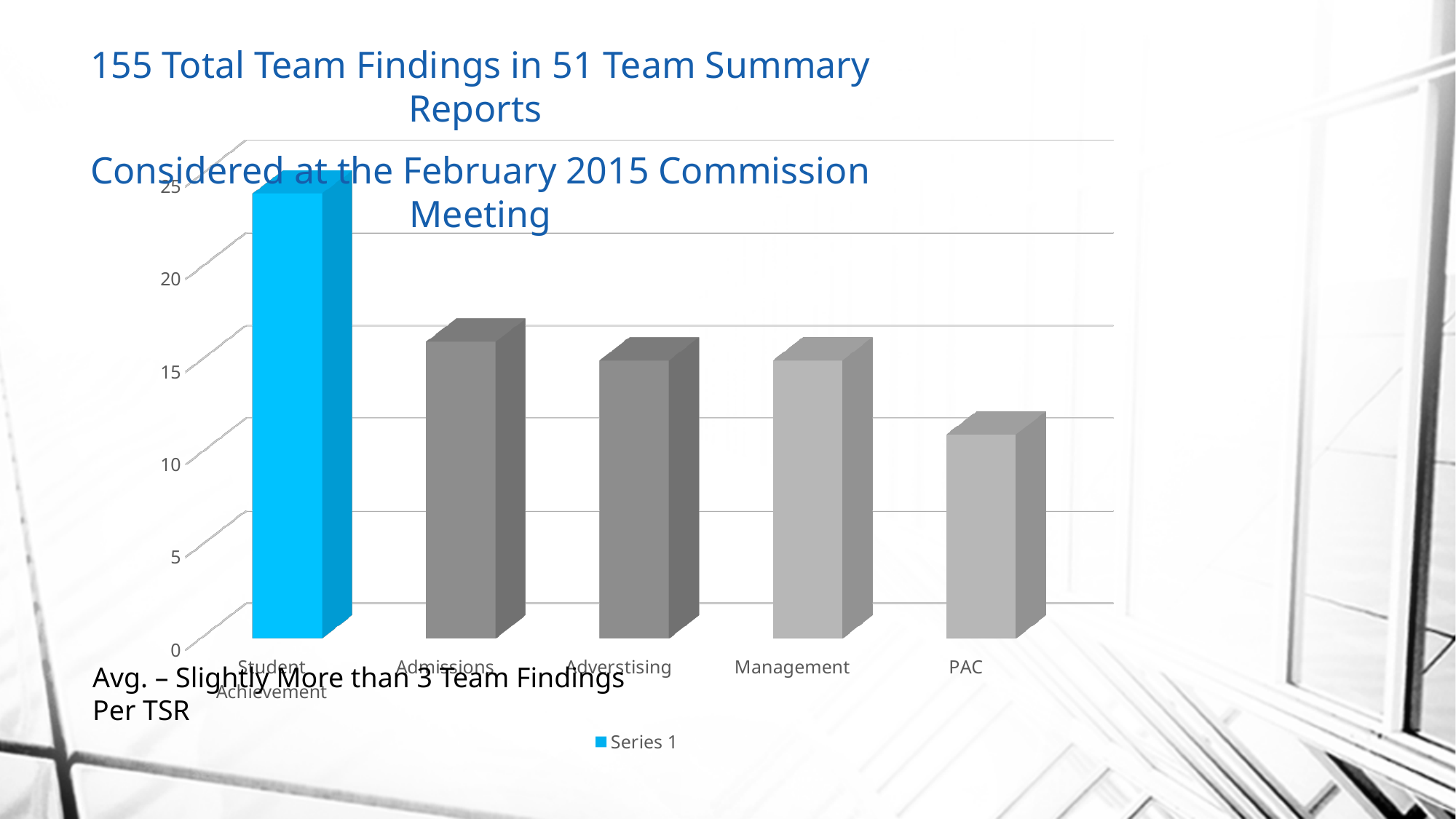
Is the value for Student Achievement greater or less than 20? greater Which is larger, the value for Student Achievement or the value for Admissions? Student Achievement Is the value for Management greater or less than 20? less What is the name of the series shown in the legend? Series 1 What kind of chart is shown on the slide? bar chart Which category has the highest value? Student Achievement Do the values generally rise or fall from left to right across the categories? fall How many series does the legend list? 1 Which is larger, the value for Admissions or the value for PAC? Admissions Is the value for PAC greater or less than 15? less Which category has the lowest value? PAC How many categories are plotted on the chart? 5